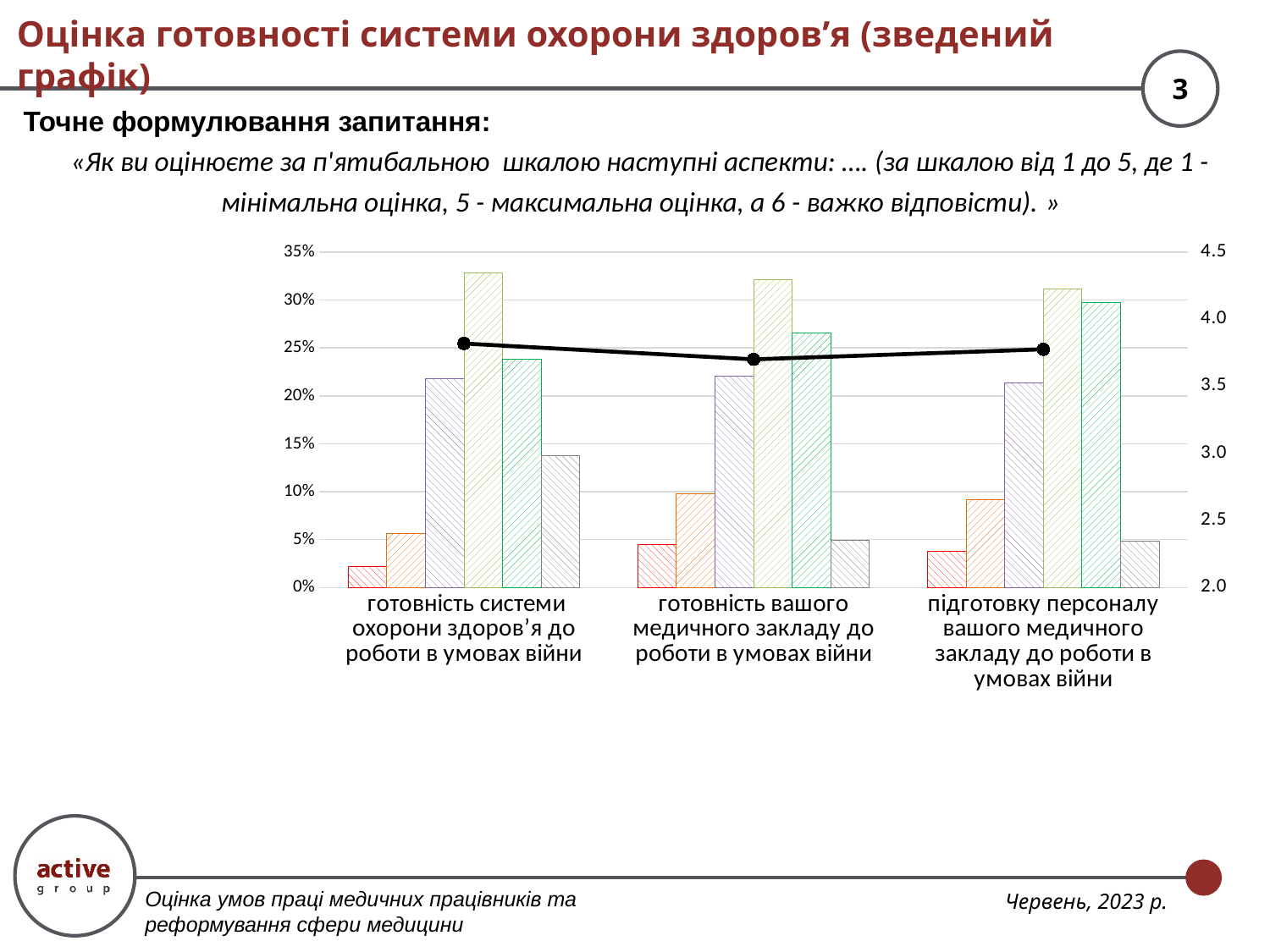
How many categories are shown on the x axis of the chart? 3 Does the black line series rise or fall from the first category to the second category? fall How many bars are plotted for each category in the chart? 6 What is the highest value shown on the left vertical axis of the chart? 35% For 'готовність системи охорони здоров’я до роботи в умовах війни', which is taller: the gray (last) bar or the orange (second) bar? gray bar Is the black line point for 'готовність вашого медичного закладу до роботи в умовах війни' greater or less than 4.0 on the right axis? less What kind of chart is shown on the slide? Combined bar and line chart Is the orange (second) bar for 'готовність вашого медичного закладу до роботи в умовах війни' greater or less than 5%? greater Is the red (first) bar for 'готовність системи охорони здоров’я до роботи в умовах війни' greater or less than 5%? less